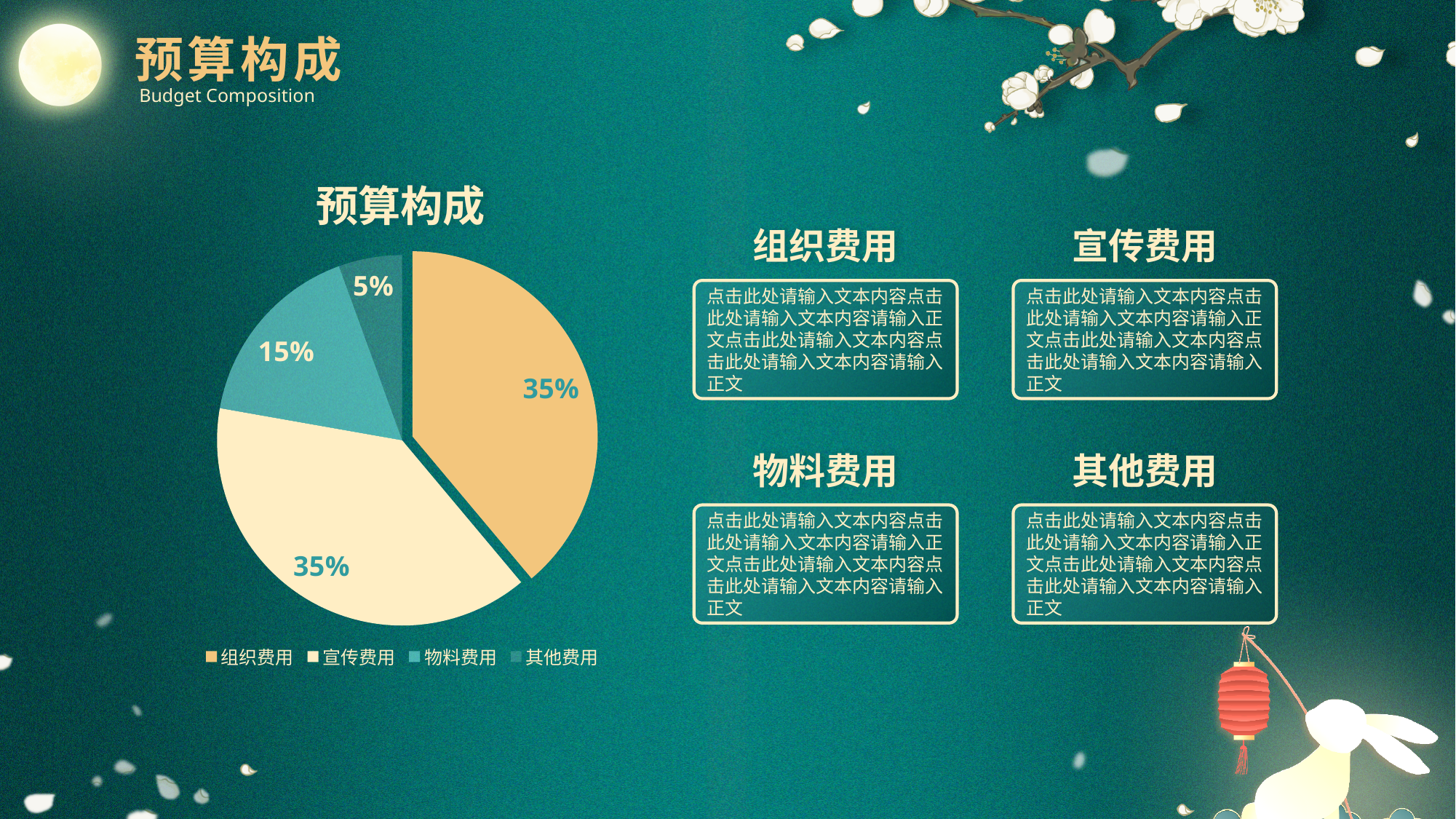
What is the difference in percentage points between 物料费用 and 其他费用? 10% Which category has the smallest slice of the pie? 其他费用 What share of the pie does 宣传费用 take? 35% Which is larger, the slice for 物料费用 or the slice for 其他费用? 物料费用 What is the chart's title? 预算构成 What is the difference in percentage points between 组织费用 and 物料费用? 20% What share of the pie does 其他费用 take? 5% What kind of chart is shown on the slide? pie chart How many slices does the pie chart have? 4 What share of the pie does 物料费用 take? 15% What share of the pie does 组织费用 take? 35% How many entries does the legend list? 4